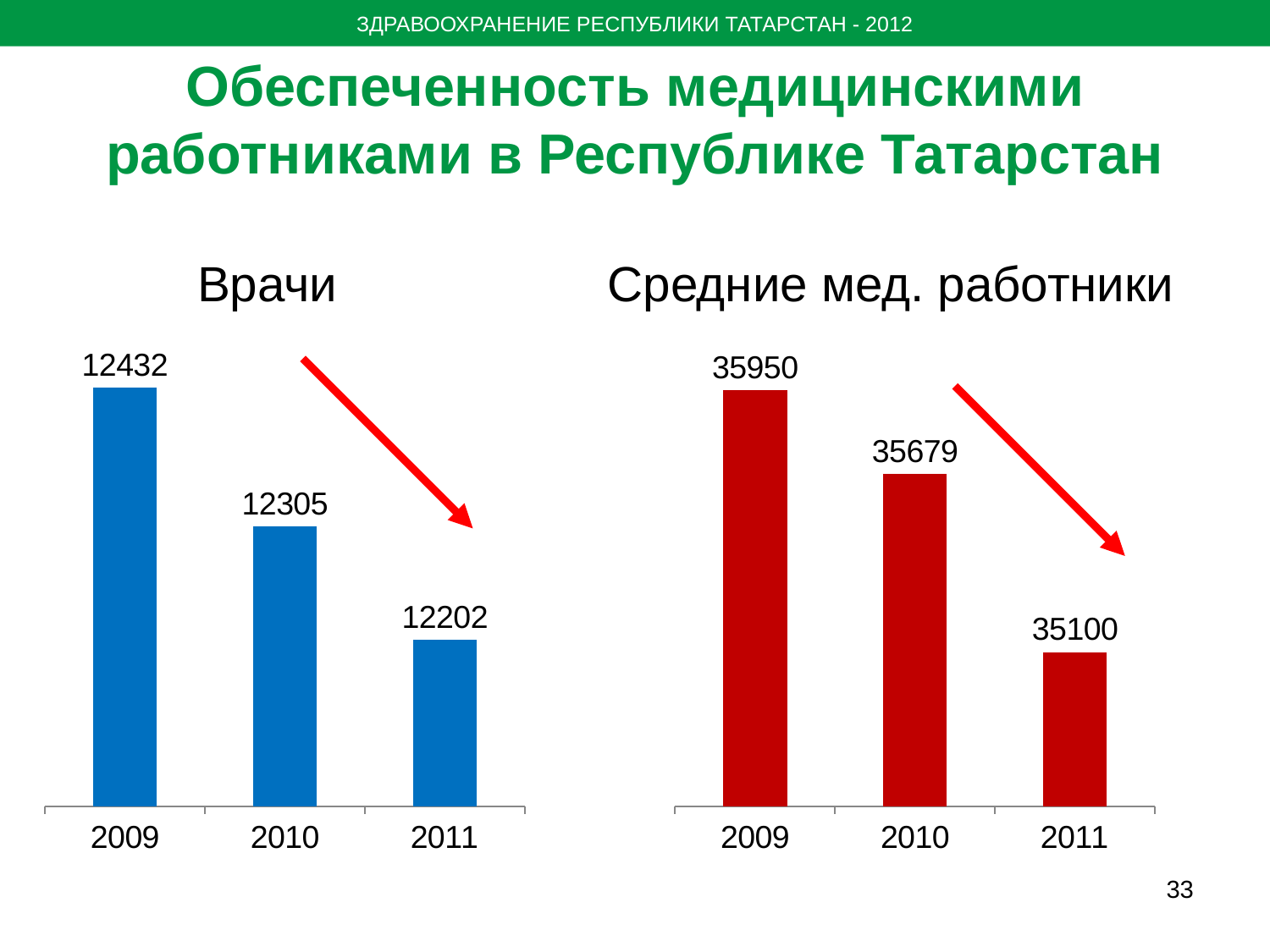
How many years are shown in the 'Средние мед. работники' chart? 3 In the 'Врачи' chart, which year has the highest value? 2009 In the 'Средние мед. работники' chart, what is the value for 2011? 35100 In the 'Средние мед. работники' chart, do the values rise or fall from 2009 to 2011? fall In the 'Средние мед. работники' chart, what is the difference between the values for 2009 and 2010? 271 In the 'Врачи' chart, what is the value for 2011? 12202 In the 'Врачи' chart, what is the difference between the values for 2009 and 2011? 230 What kind of chart is the 'Врачи' chart? bar chart In the 'Врачи' chart, what is the value for 2009? 12432 In the 'Врачи' chart, which is larger, the value for 2010 or the value for 2011? 2010 In the 'Средние мед. работники' chart, what is the value for 2010? 35679 In the 'Средние мед. работники' chart, which year has the lowest value? 2011